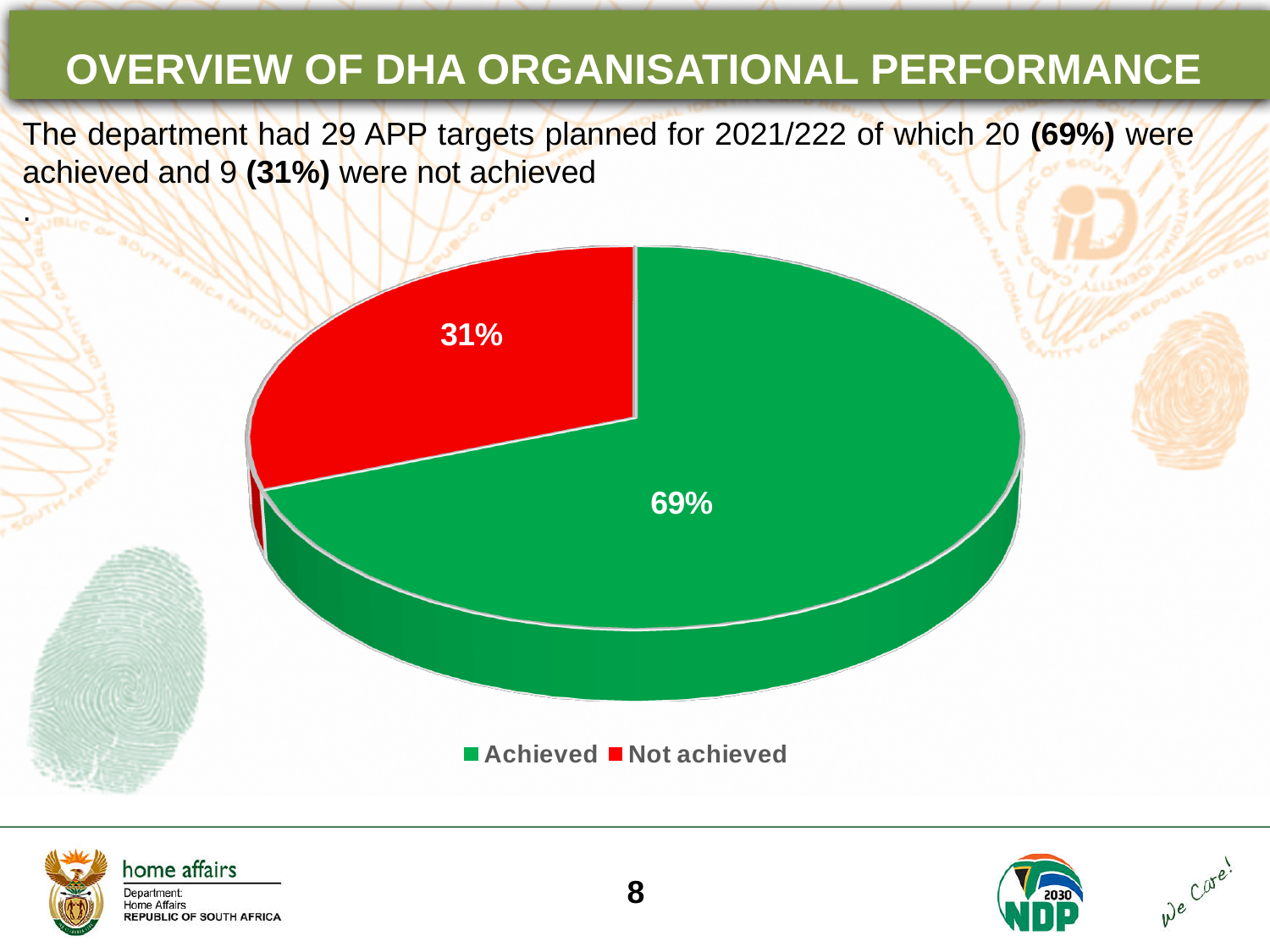
How many entries does the legend list? 2 What colour is the Not achieved slice? Red Which slice of the pie is the largest? Achieved How many slices does the pie chart have? 2 What share of the pie does the Not achieved slice represent? 31% Which slice of the pie is the smallest? Not achieved What colour is the Achieved slice? Green What share of the pie does the Achieved slice represent? 69% Which is larger, the Achieved slice or the Not achieved slice? Achieved What kind of chart is shown on the slide? Pie chart What is the difference in percentage points between the Achieved and Not achieved slices? 38